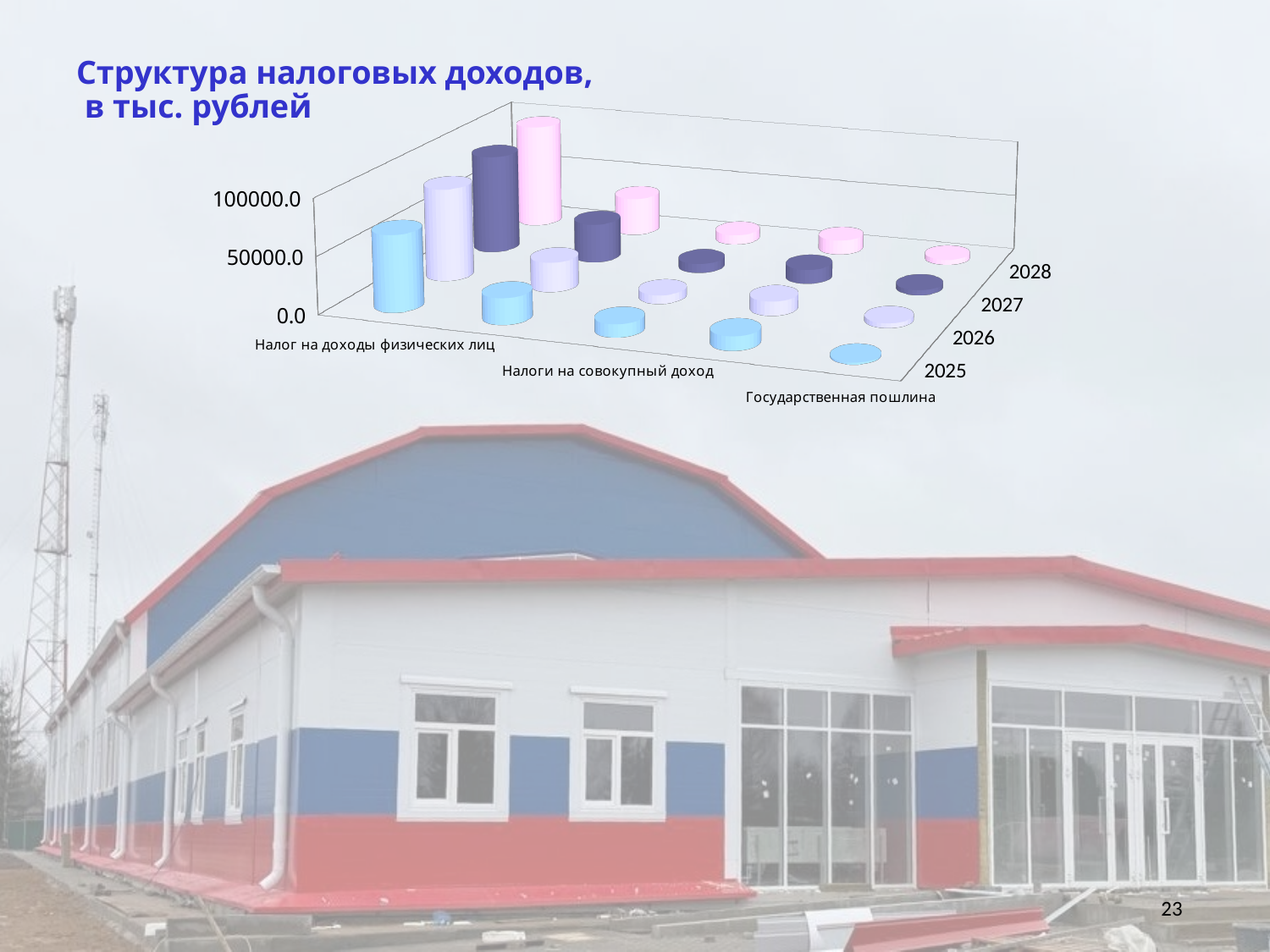
What kind of chart is shown on the slide? bar chart What is the title of the chart? Структура налоговых доходов, в тыс. рублей In 2025, which is larger: Налог на доходы физических лиц or Государственная пошлина? Налог на доходы физических лиц Which tax category has the highest values in the chart? Налог на доходы физических лиц Is the value for Государственная пошлина in 2025 greater or less than 50000.0? less Do the values for Налог на доходы физических лиц rise or fall from 2025 to 2028? rise How many years are shown on the depth axis of the chart? 4 What is the highest tick value shown on the vertical axis of the chart? 100000.0 For Налог на доходы физических лиц, which year has the highest value? 2028 Is the value for Налоги на совокупный доход in 2028 greater or less than 50000.0? less Which tax category has the lowest values in the chart? Государственная пошлина